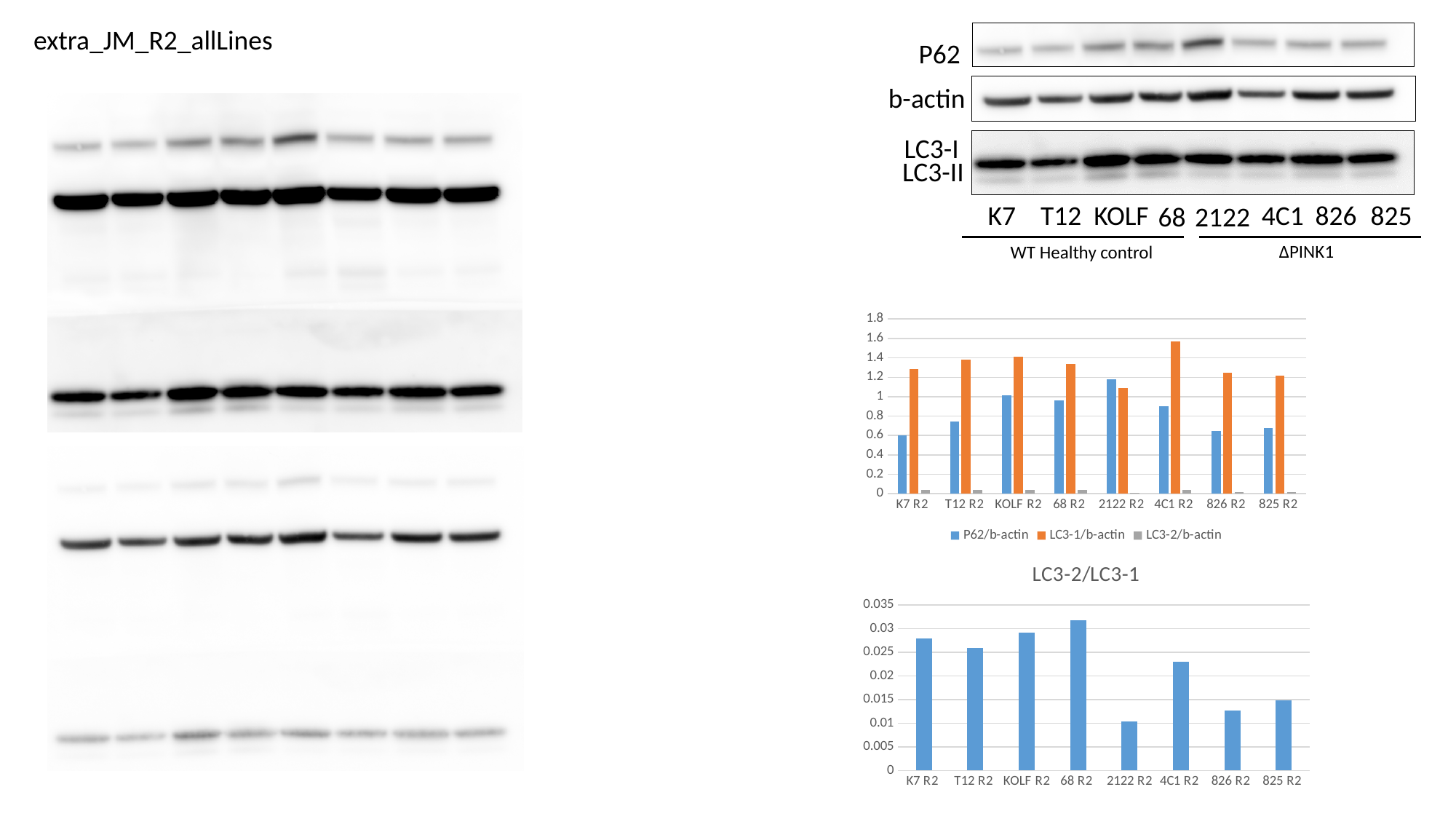
In the lower chart titled "LC3-2/LC3-1", is the value for 2122 R2 greater or less than 0.015? less In the upper chart, for K7 R2, which is larger: P62/b-actin or LC3-1/b-actin? LC3-1/b-actin In the upper chart, which category has the highest LC3-1/b-actin value? 4C1 R2 How many series does the legend of the upper chart list? 3 In the upper chart, is the P62/b-actin value for 2122 R2 greater or less than 1? greater How many categories are shown on the x axis of the lower chart titled "LC3-2/LC3-1"? 8 What kind of chart is the lower chart titled "LC3-2/LC3-1"? bar chart In the upper chart, which category has the highest P62/b-actin value? 2122 R2 In the lower chart titled "LC3-2/LC3-1", which category has the highest value? 68 R2 In the lower chart titled "LC3-2/LC3-1", which category has the lowest value? 2122 R2 In the upper chart, which category has the lowest LC3-1/b-actin value? 2122 R2 In the lower chart titled "LC3-2/LC3-1", which is larger: the value for K7 R2 or the value for 825 R2? K7 R2